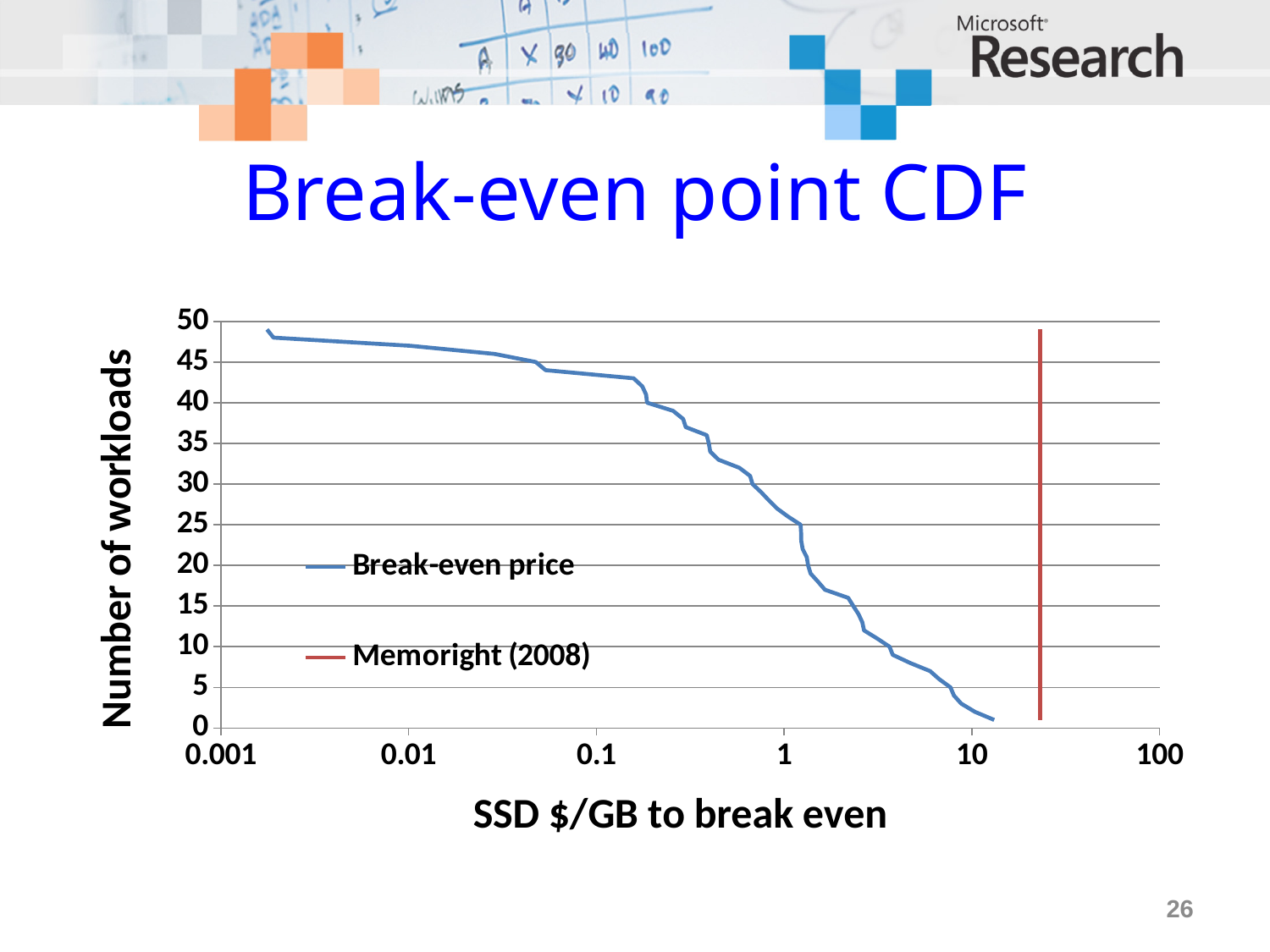
Is the number of workloads on the Break-even price line at 10 $/GB greater or less than 5? less What is the title of the chart? Break-even point CDF Does the Break-even price line rise or fall as the SSD $/GB value increases along the x axis? fall Is the SSD $/GB value where the Memoright (2008) line is drawn greater or less than 100? less What is the label of the x axis? SSD $/GB to break even Is the number of workloads on the Break-even price line at 0.01 $/GB greater or less than 40? greater What kind of chart is shown on the slide? line chart How many series does the legend list? 2